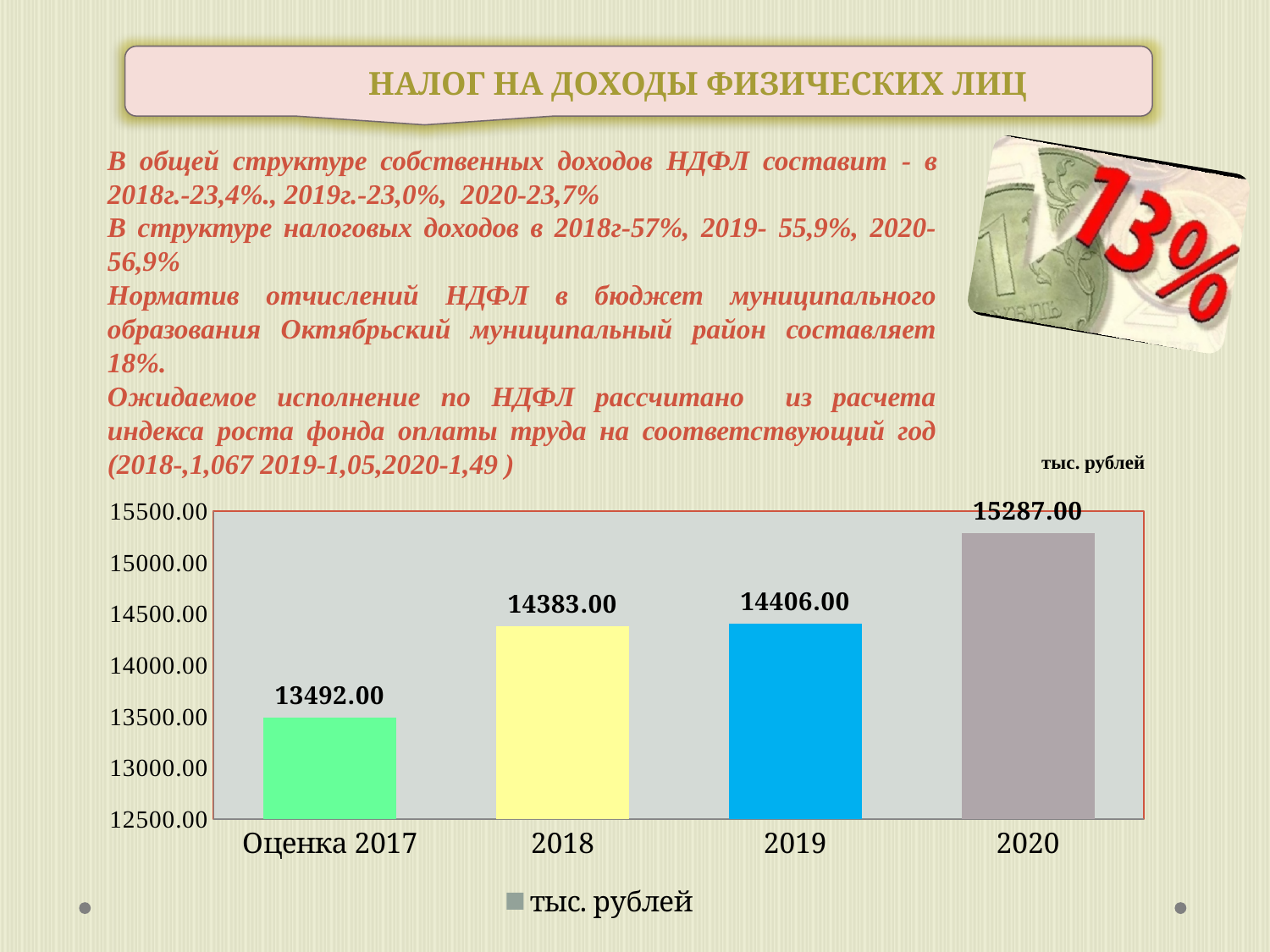
What is the difference between the values for 2020 and Оценка 2017? 1795.00 How many categories are shown on the x axis? 4 What is the value for 2020? 15287.00 What is the difference between the values for 2019 and 2018? 23.00 What kind of chart is shown on the slide? bar chart What is the value for 2018? 14383.00 Which category has the lowest value? Оценка 2017 What is the value for Оценка 2017? 13492.00 What is the value for 2019? 14406.00 Which is larger, the value for 2018 or the value for 2020? 2020 Do the values rise or fall from Оценка 2017 to 2020? rise Which category has the highest value? 2020